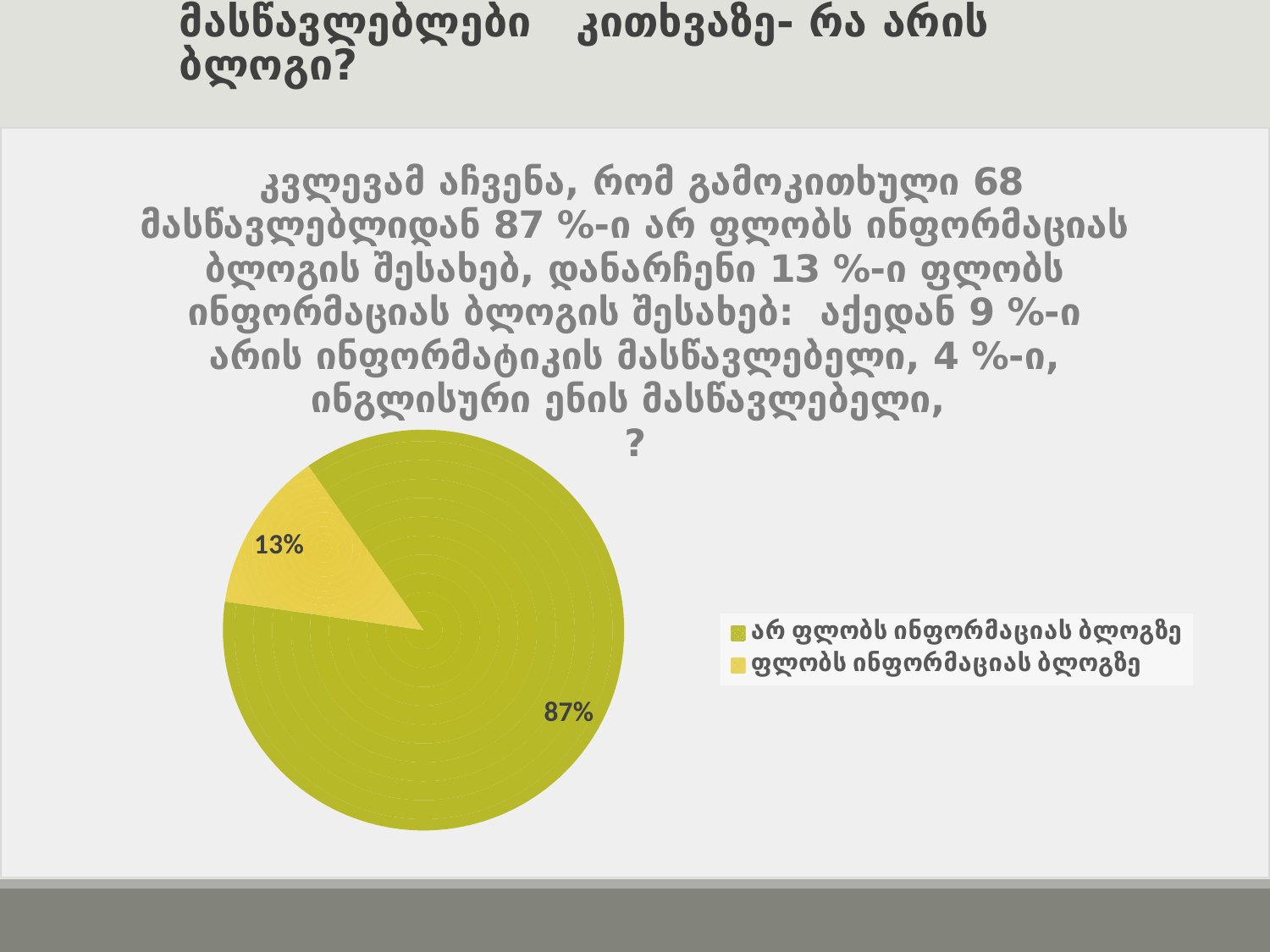
Where is the legend positioned relative to the pie chart? to the right Which slice of the pie chart is the largest? არ ფლობს ინფორმაციას ბლოგზე What colour is the "ფლობს ინფორმაციას ბლოგზე" slice in the pie chart? yellow What kind of chart is shown on the slide? pie chart What share of the pie does the "ფლობს ინფორმაციას ბლოგზე" slice represent? 13% How many slices does the pie chart have? 2 Which is larger: the "ფლობს ინფორმაციას ბლოგზე" slice or the "არ ფლობს ინფორმაციას ბლოგზე" slice? არ ფლობს ინფორმაციას ბლოგზე Which slice of the pie chart is the smallest? ფლობს ინფორმაციას ბლოგზე What is the difference in percentage points between the "არ ფლობს ინფორმაციას ბლოგზე" slice and the "ფლობს ინფორმაციას ბლოგზე" slice? 74 How many entries does the legend of the pie chart list? 2 What percentage is shown for the slice labelled "არ ფლობს ინფორმაციას ბლოგზე"? 87% What percentage is shown for the slice labelled "ფლობს ინფორმაციას ბლოგზე"? 13%